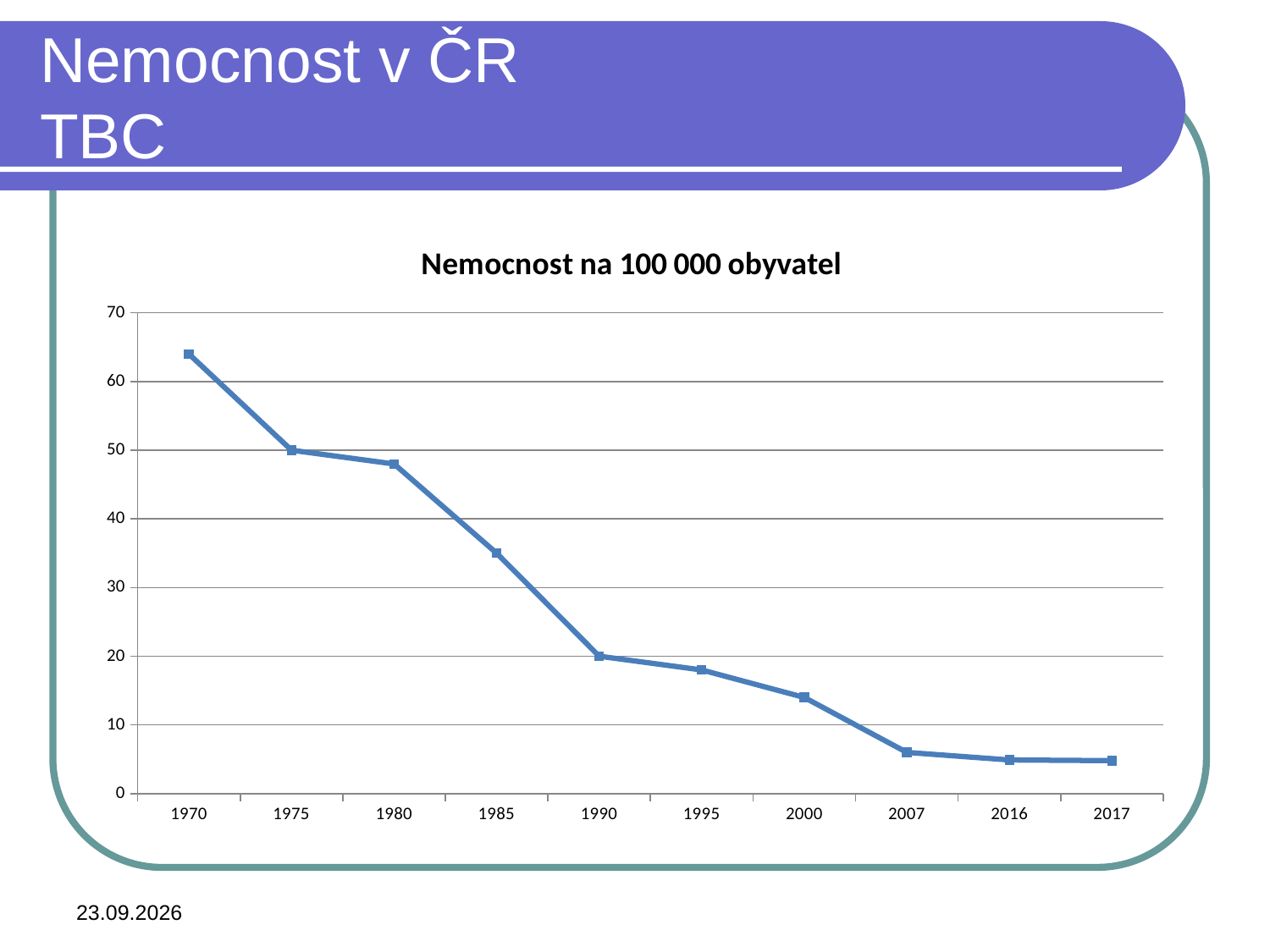
Which year has the highest value on the chart? 1970 Do the values rise or fall from 1970 to 2017? fall Which is larger, the value for 1980 or the value for 1995? 1980 Is the value for 1970 greater or less than 60? greater How many data points are plotted on the chart? 10 Is the value for 1985 greater or less than 40? less What is the value for 1990? 20 What kind of chart is shown on the slide? line chart What is the value for 1975? 50 Is the value for 2007 greater or less than 10? less What is the title of the chart? Nemocnost na 100 000 obyvatel